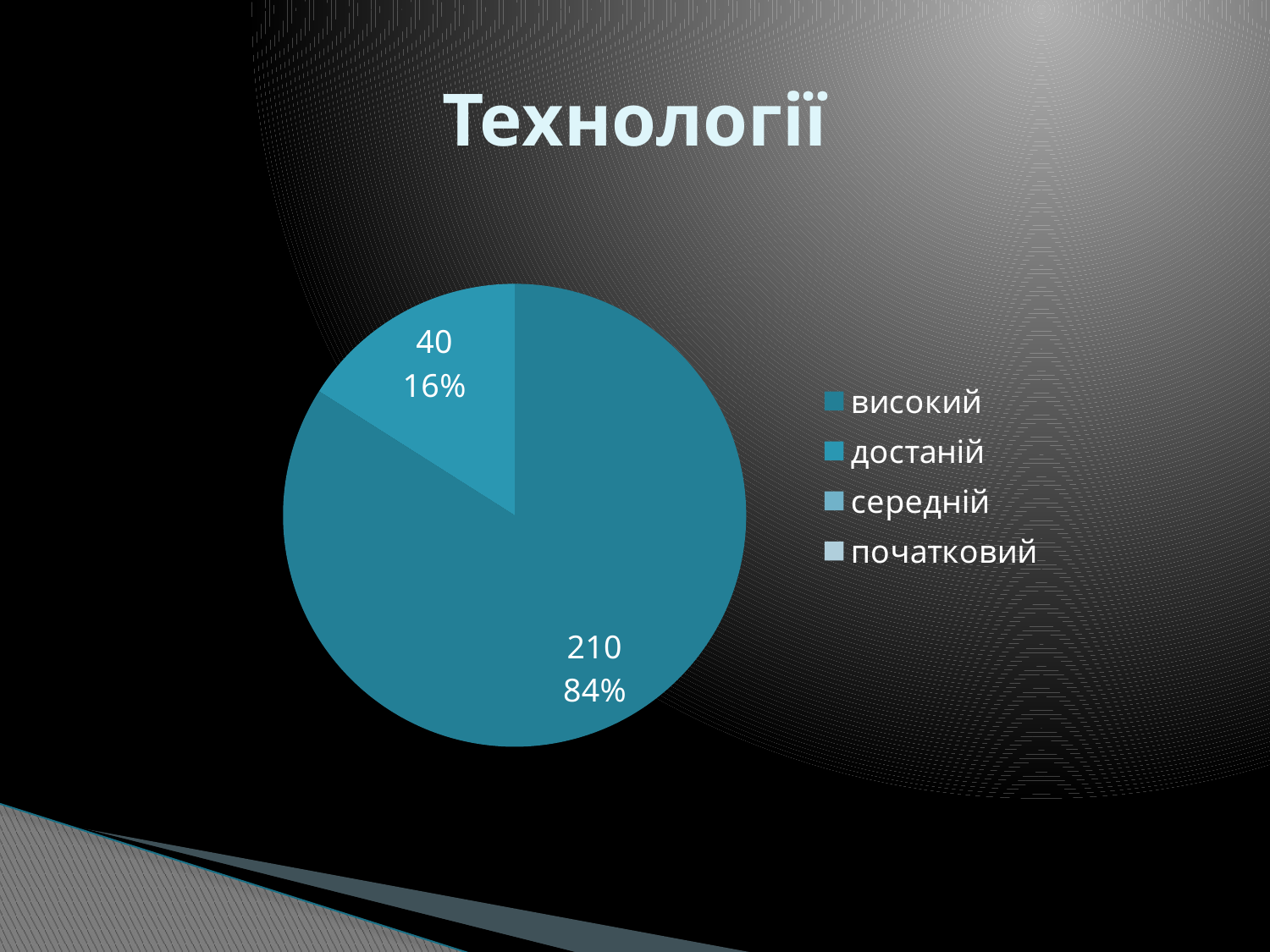
What percentage share does the slice labelled 210 have? 84% What kind of chart is shown on the slide? pie chart Which legend category corresponds to the largest slice of the pie? високий What is the total of the two labelled slice values? 250 What value is shown on the smaller labelled slice of the pie? 40 How many entries does the chart legend list? 4 Which is larger, the slice for високий or the slice for достаній? високий What is the title of the chart? Технології What is the difference between the two labelled slice values, 210 and 40? 170 What percentage share does the slice labelled 40 have? 16% What value is shown on the largest slice of the pie? 210 Which legend category corresponds to the slice labelled 40? достаній